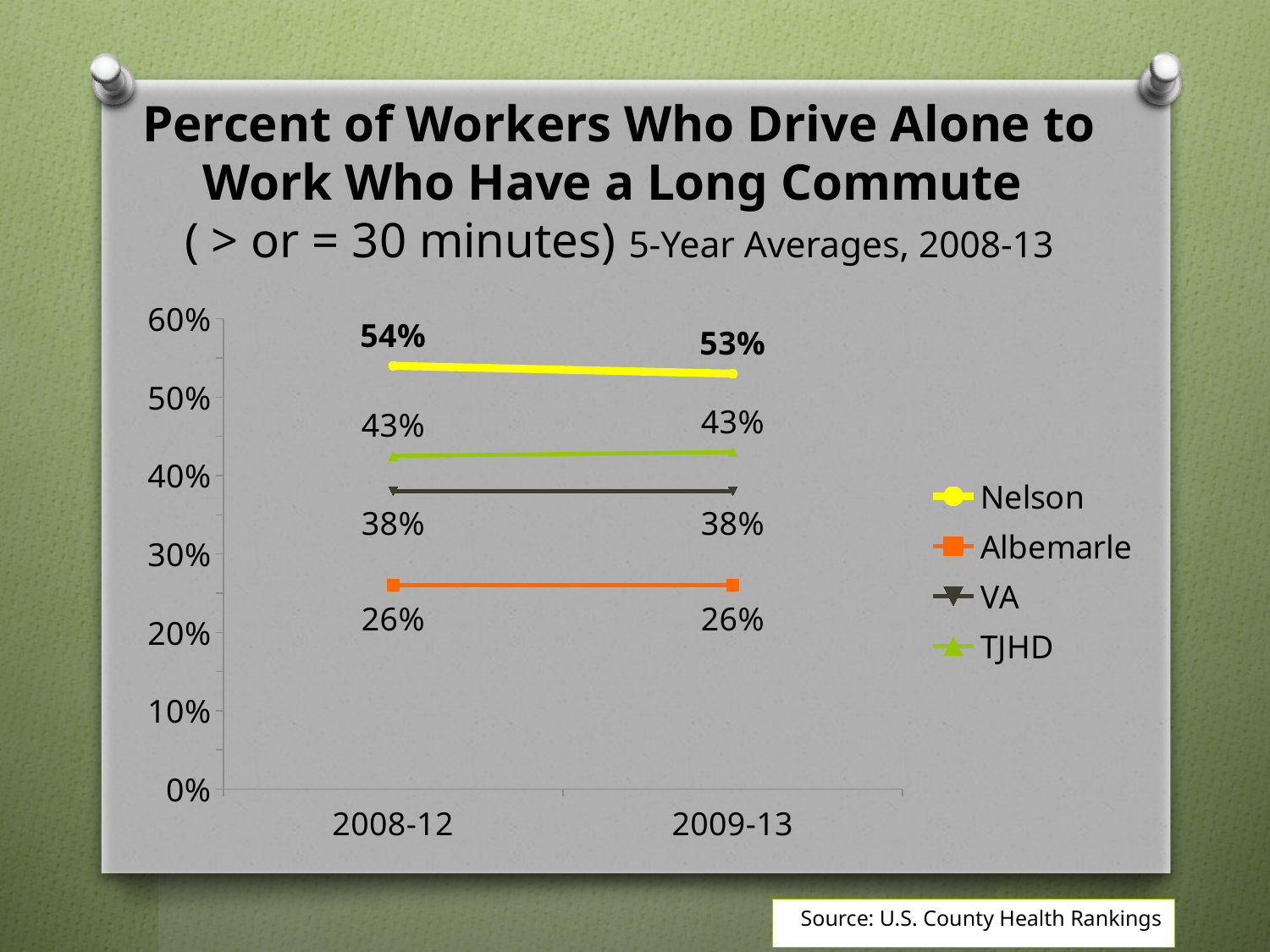
What is the value for Albemarle in 2009-13? 26% Which series has the lowest value in 2008-12? Albemarle What kind of chart is shown on the slide? Line chart Does the Nelson value rise or fall from 2008-12 to 2009-13? Fall What is the value for Nelson in 2008-12? 54% What is the difference between the Nelson and Albemarle values in 2008-12? 28% What is the value for TJHD in 2008-12? 43% What is the value for Nelson in 2009-13? 53% What is the value for VA in 2009-13? 38% How many series does the legend list? 4 Which series has the highest value in 2009-13? Nelson Which is larger in 2009-13, the value for TJHD or the value for VA? TJHD